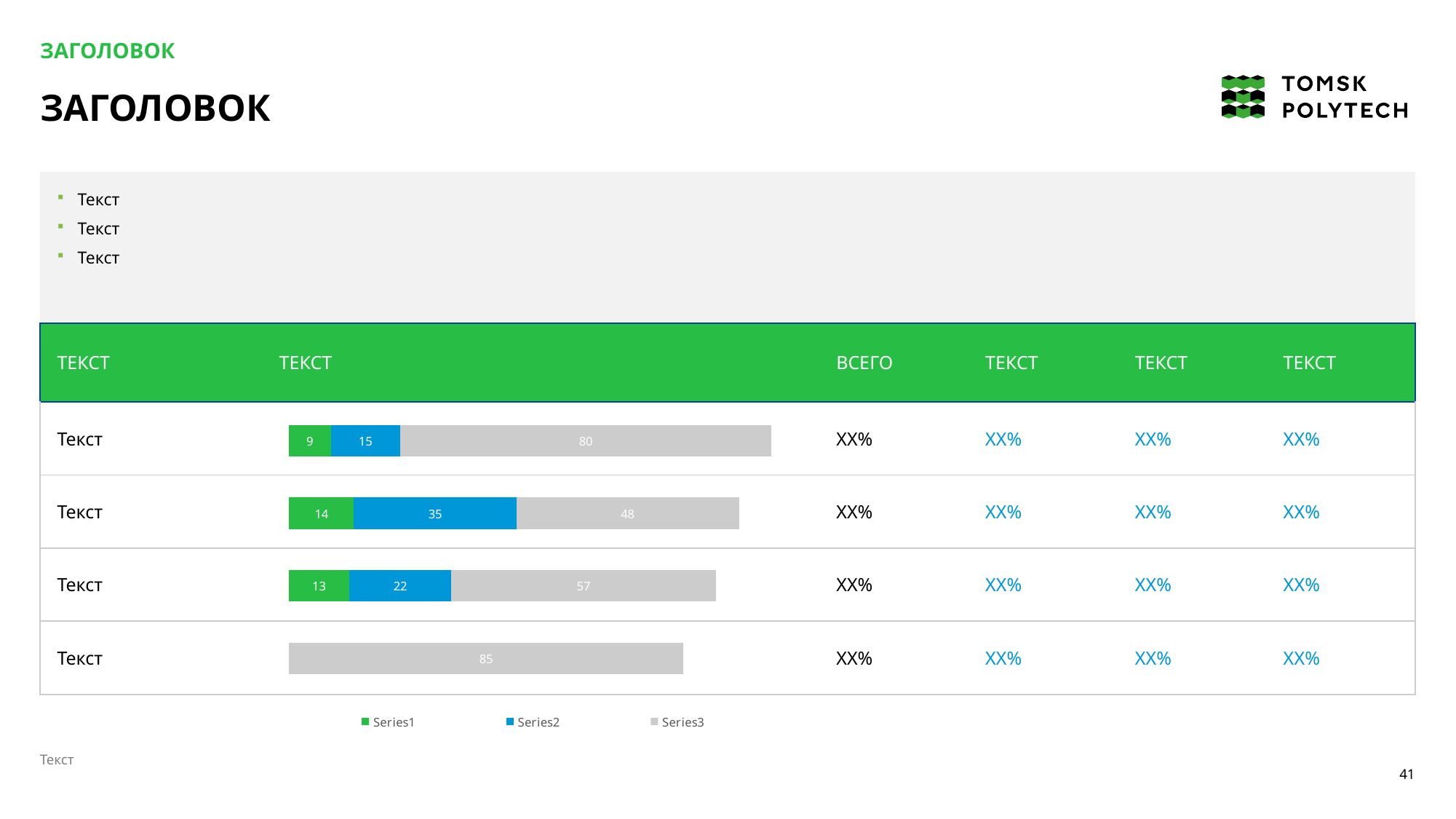
What kind of chart is shown in the table on the slide? stacked bar chart What is the difference between the Series2 values of the second and third bars from the top? 13 Which colour represents Series2 in the chart? blue Which bar has the lowest Series1 value among the bars that show Series1? the first (top) bar What is the Series3 value in the third bar from the top? 57 What is the Series1 value in the first (top) bar? 9 What is the value shown in the bottom bar? 85 What is the Series2 value in the second bar from the top? 35 How many series does the chart legend list? 3 How many bars (rows) does the chart contain? 4 Which bar has the highest Series3 value? the bottom (fourth) bar What is the total of the first (top) stacked bar? 104